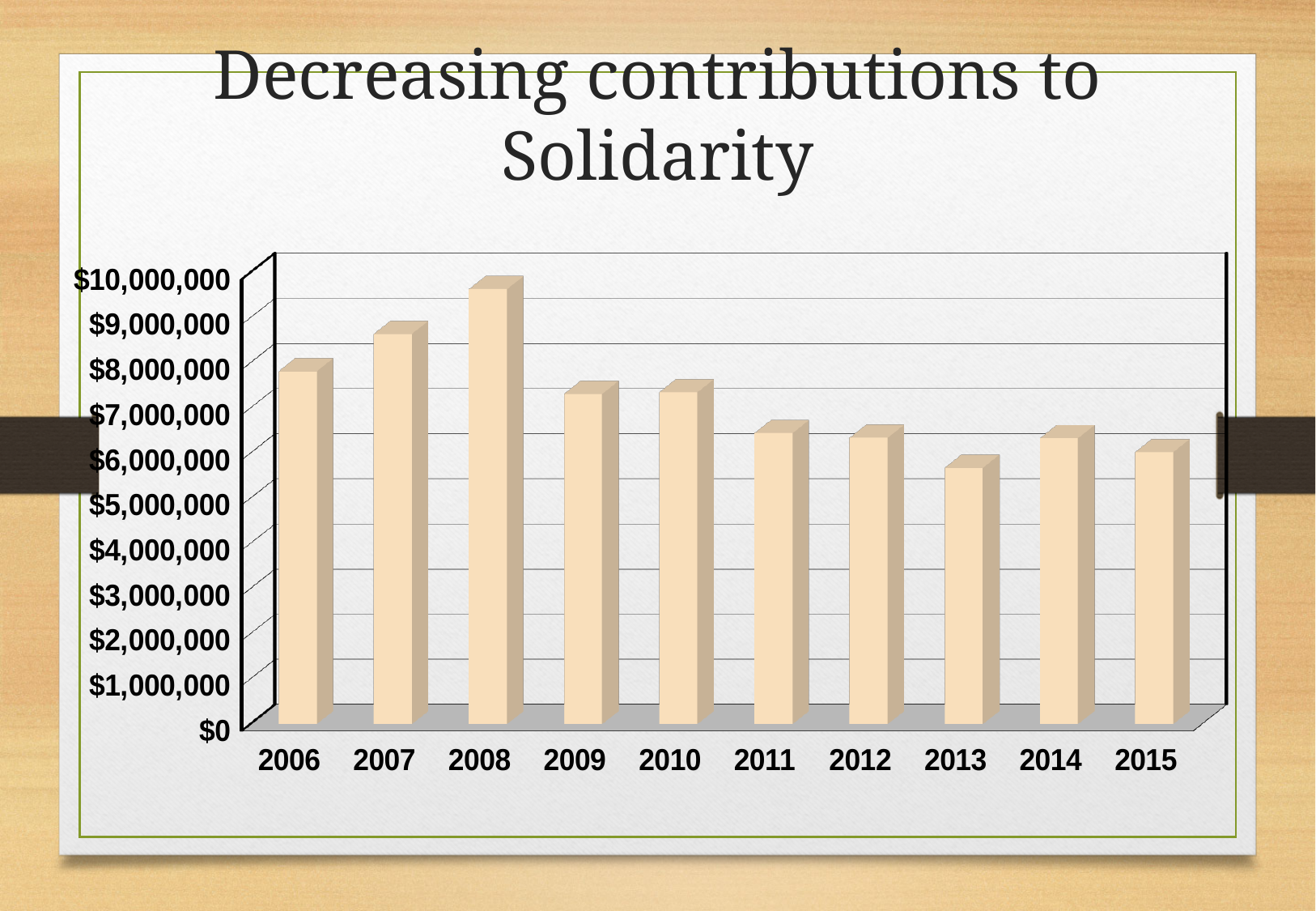
Which year has the lowest contribution in the chart? 2013 Is the value for 2007 greater or less than $8,000,000? greater How many years are shown on the x axis of the chart? 10 Is the value for 2009 greater or less than $8,000,000? less What kind of chart is shown on the slide? bar chart Which year has a larger contribution, 2013 or 2014? 2014 Is the value for 2008 greater or less than $9,000,000? greater Which year has a larger contribution, 2006 or 2008? 2008 Do the contributions generally rise or fall from 2008 to 2015? fall Which year has the highest contribution in the chart? 2008 What is the title of the slide containing the chart? Decreasing contributions to Solidarity